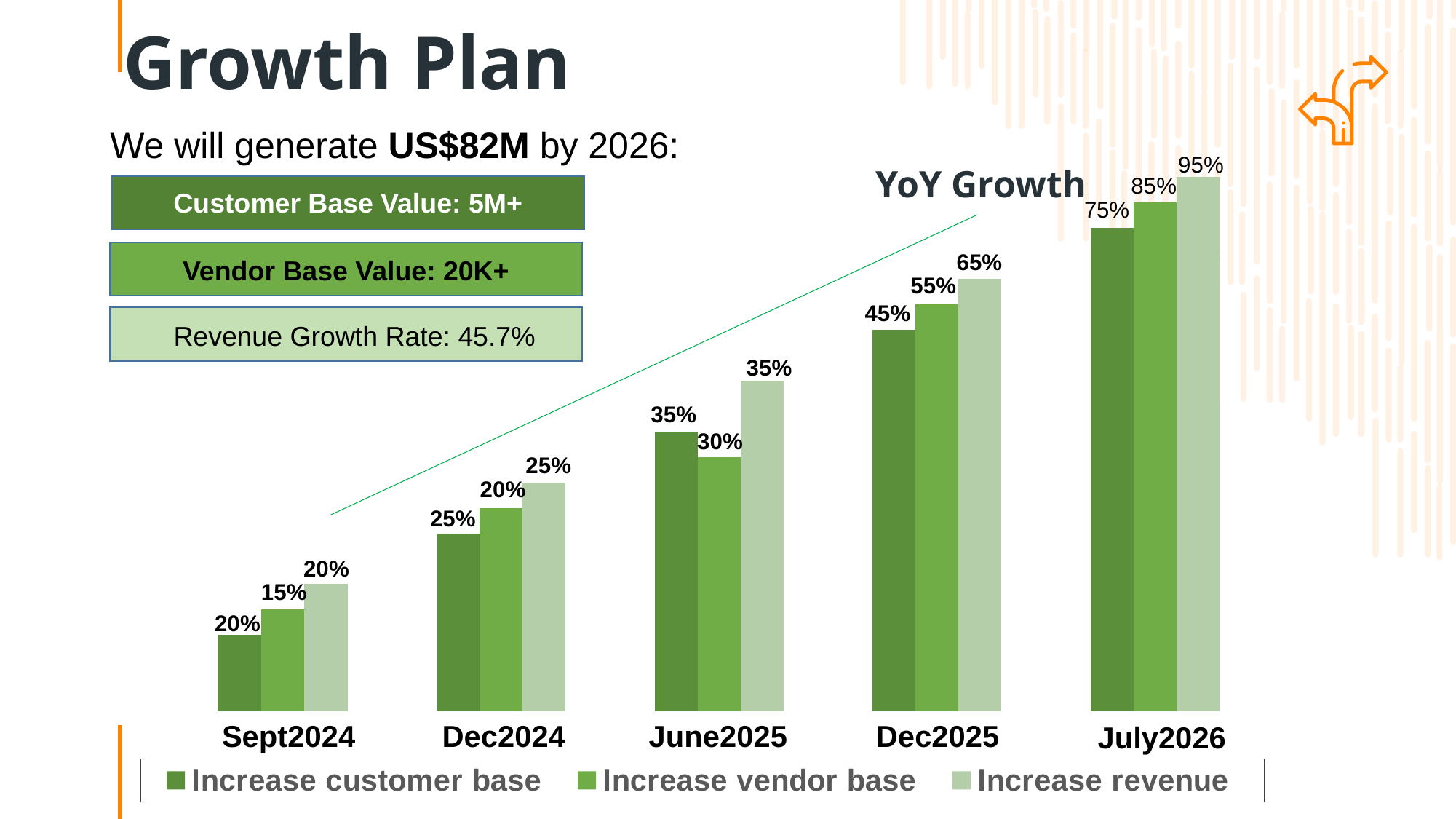
In June2025, which is larger: Increase customer base or Increase vendor base? Increase customer base How many periods are shown on the x axis? 5 What is the value for Increase customer base in Sept2024? 20% Which period has the highest value for Increase revenue? July2026 Which period has the lowest value for Increase vendor base? Sept2024 Do the Increase revenue values rise or fall from Sept2024 to July2026? Rise What is the difference between Increase revenue and Increase customer base in Dec2025? 20% What is the value for Increase vendor base in Dec2025? 55% How many series does the legend list? 3 What kind of chart is shown? Bar chart What is the value for Increase revenue in July2026? 95% What is the value for Increase vendor base in June2025? 30%